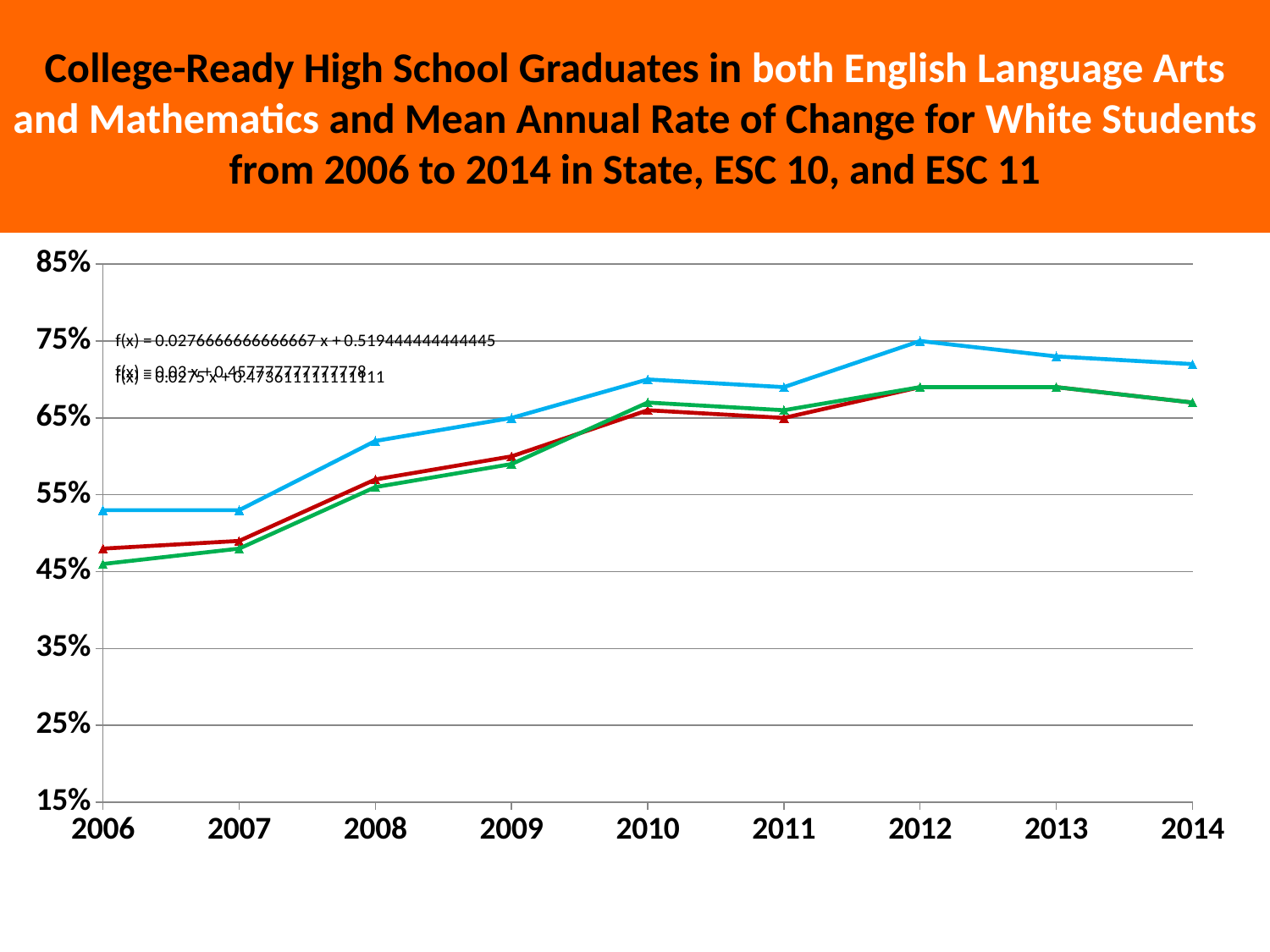
Which line is the highest across all years on the chart? The blue line Is the value of the blue line in 2008 greater or less than 65%? less What kind of chart is shown on the slide? Line chart How many years are shown along the x axis of the chart? 9 How many lines are plotted on the chart? 3 What is the lowest value shown on the y axis of the chart? 15% Is the value of the red line in 2006 greater or less than 45%? greater In 2010, which is higher, the blue line or the green line? The blue line In which year does the blue line reach its highest value? 2012 Is the value of the blue line in 2014 greater or less than 65%? greater In which year is the green line at its lowest value? 2006 Does the blue line rise or fall from 2006 to 2012? Rise